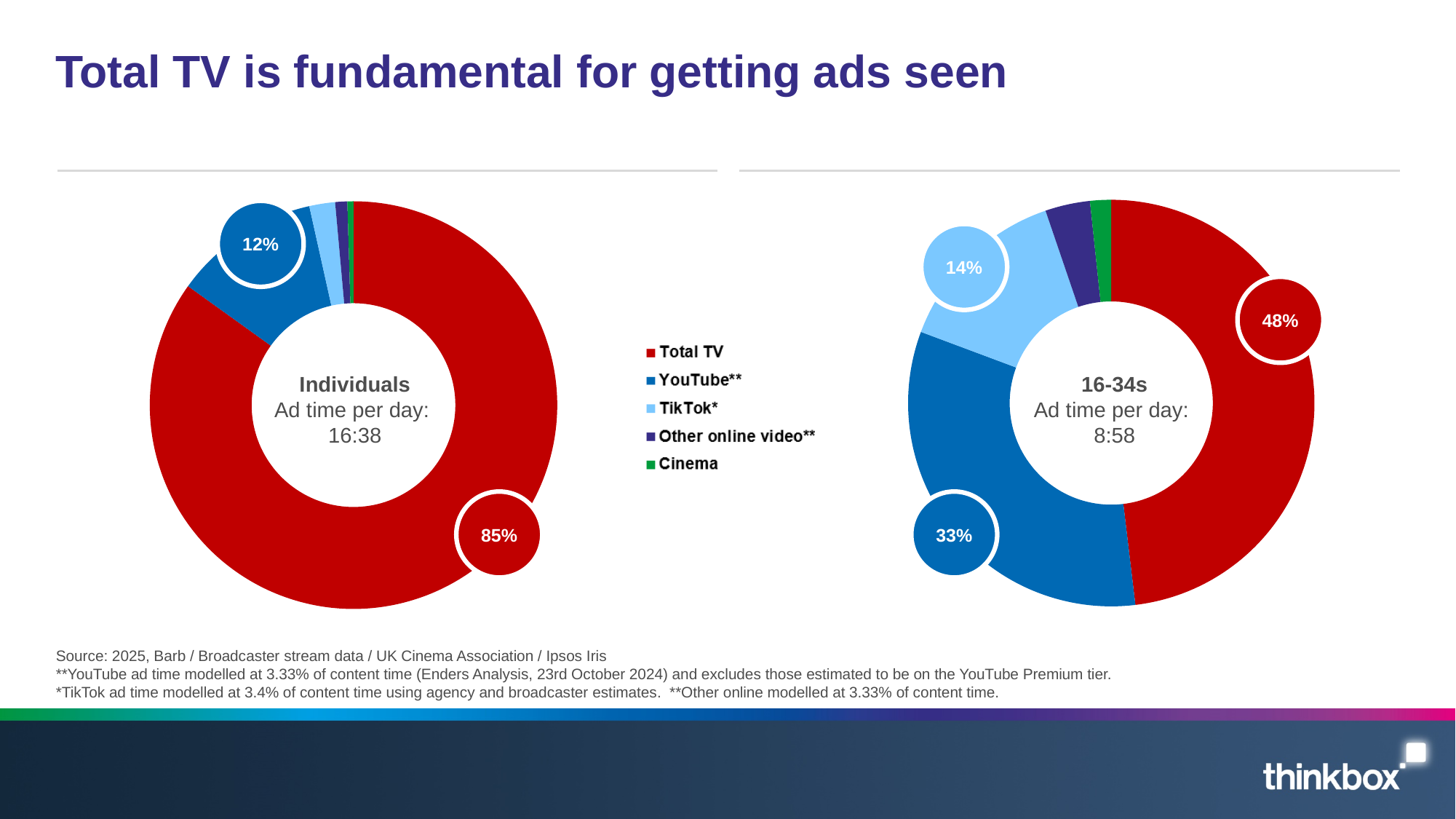
In the 16-34s chart, what share of ad time per day is Total TV? 48% In the Individuals chart, what share of ad time per day is Total TV? 85% In the Individuals chart, which category has the largest share? Total TV In the Individuals chart, what share of ad time per day is YouTube? 12% In the 16-34s chart, what is the difference between the Total TV share and the YouTube share? 15 percentage points What is the ad time per day shown in the centre of the 16-34s chart? 8:58 In the 16-34s chart, what share of ad time per day is YouTube? 33% What type of chart is used on this slide? Pie (donut) chart How many categories does the legend list? 5 Which is larger in the 16-34s chart: the YouTube share or the TikTok share? YouTube In the 16-34s chart, what share of ad time per day is TikTok? 14% In the 16-34s chart, which category has the largest share? Total TV